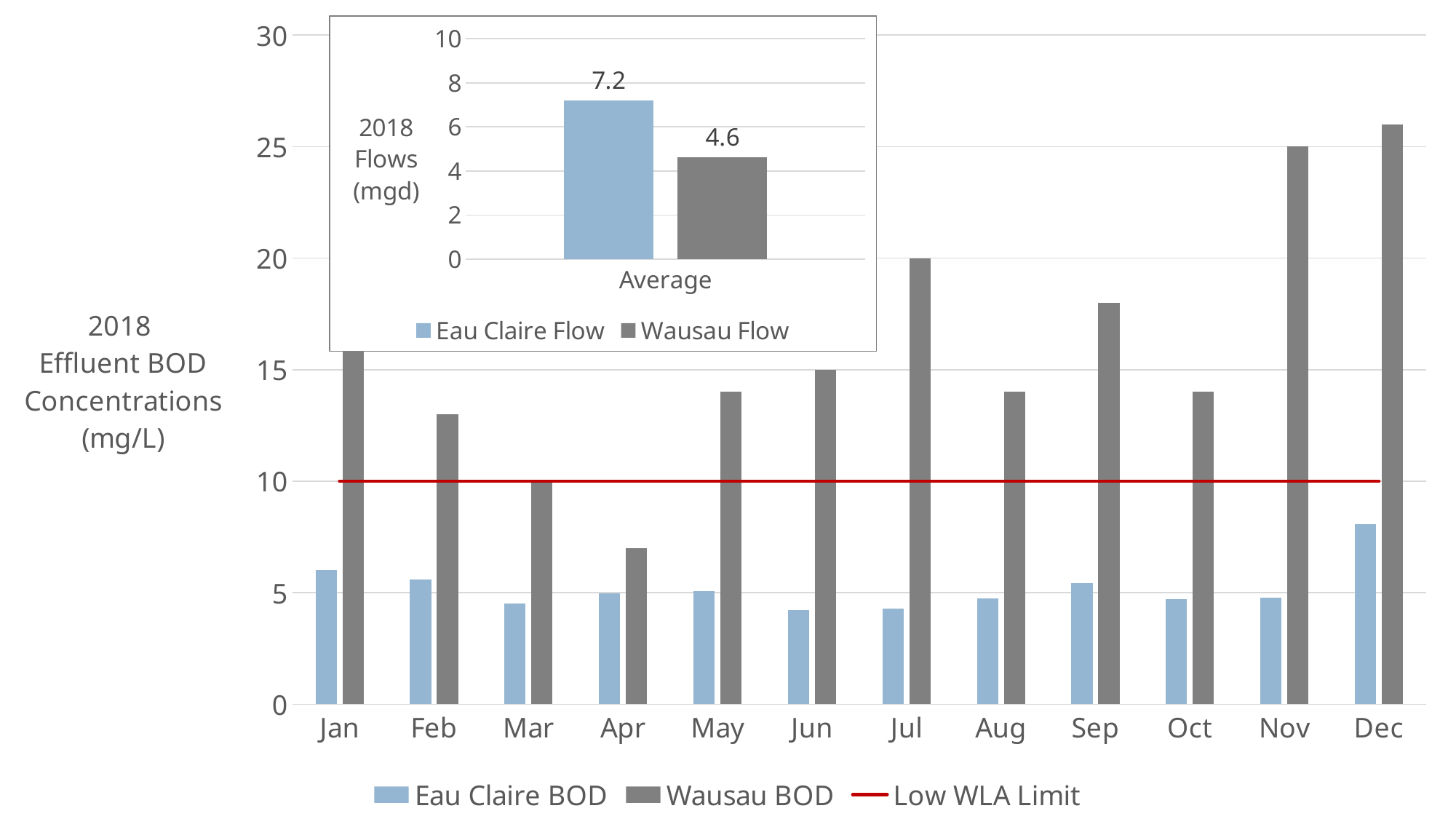
In the main chart titled 2018 Effluent BOD Concentrations (mg/L), is the Wausau BOD value for Apr greater or less than 10? less What kind of chart is the main chart titled 2018 Effluent BOD Concentrations (mg/L)? Combination bar and line chart In the main chart titled 2018 Effluent BOD Concentrations (mg/L), in which month is the Wausau BOD lowest? Apr In the inset chart titled 2018 Flows (mgd), what is the average Wausau Flow? 4.6 In the inset chart titled 2018 Flows (mgd), what is the average Eau Claire Flow? 7.2 In the main chart titled 2018 Effluent BOD Concentrations (mg/L), how many months are shown on the x axis? 12 In the inset chart titled 2018 Flows (mgd), which is larger, Eau Claire Flow or Wausau Flow? Eau Claire Flow In the inset chart titled 2018 Flows (mgd), what is the difference between the Eau Claire Flow and the Wausau Flow? 2.6 In the main chart titled 2018 Effluent BOD Concentrations (mg/L), in which month is the Eau Claire BOD highest? Dec In the main chart titled 2018 Effluent BOD Concentrations (mg/L), is the Eau Claire BOD value for Dec greater or less than 10? less In the main chart titled 2018 Effluent BOD Concentrations (mg/L), how many entries does the legend list? 3 In the main chart titled 2018 Effluent BOD Concentrations (mg/L), is the Wausau BOD value for Jul greater or less than 15? greater